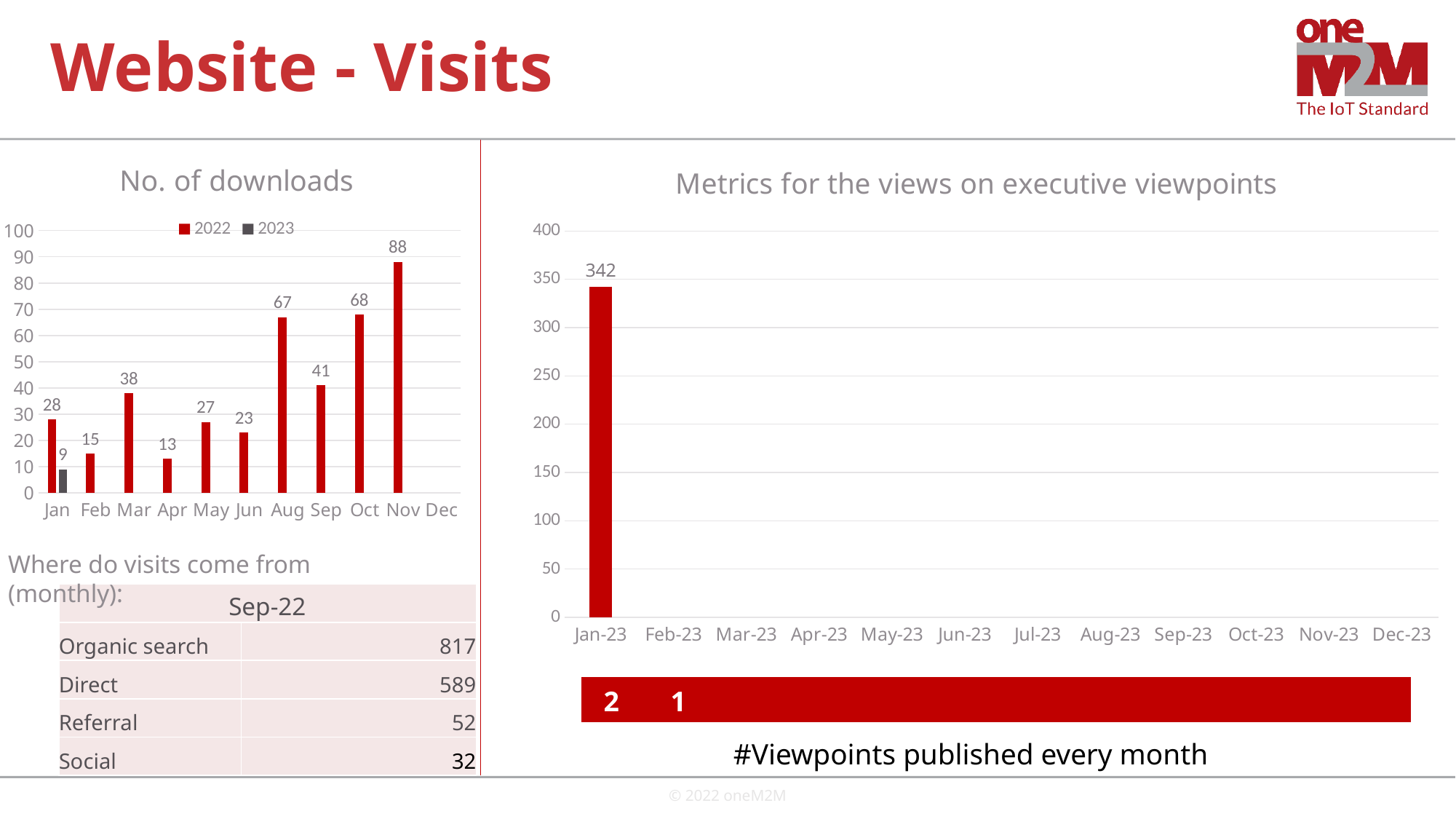
In the 'No. of downloads' chart, what is the 2023 value for Jan? 9 What kind of chart is 'Metrics for the views on executive viewpoints'? bar chart In the 'No. of downloads' chart, what is the difference between the 2022 values for Oct and Aug? 1 In the 'No. of downloads' chart, what is the difference between the 2022 and 2023 values for Jan? 19 In the 'No. of downloads' chart, what is the 2022 value for Nov? 88 In the 'No. of downloads' chart, which month has the highest 2022 value? Nov In the 'No. of downloads' chart, which month has the lowest labelled 2022 value? Apr In the 'Metrics for the views on executive viewpoints' chart, how many month categories are shown on the x axis? 12 In the 'Metrics for the views on executive viewpoints' chart, what is the value for Jan-23? 342 In the 'Metrics for the views on executive viewpoints' chart, is the value for Jan-23 greater or less than 300? greater In the 'No. of downloads' chart, how many series does the legend list? 2 In the 'No. of downloads' chart, which is larger for 2022: Mar or Sep? Sep